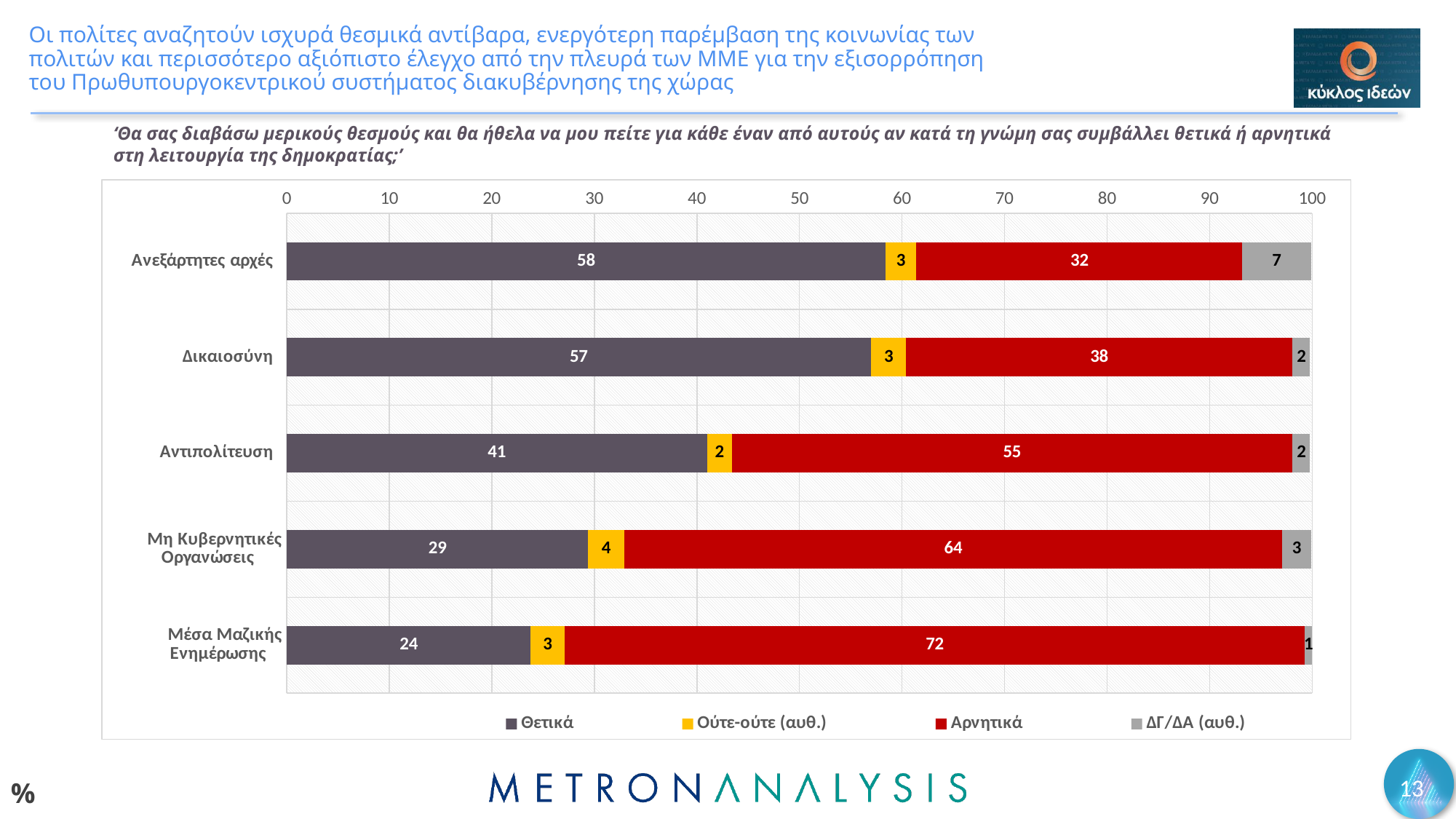
Which category has the highest Θετικά value? Ανεξάρτητες αρχές How many series does the legend list? 4 What is the ΔΓ/ΔΑ (αυθ.) value for Ανεξάρτητες αρχές? 7 What is the Αρνητικά value for Μέσα Μαζικής Ενημέρωσης? 72 What is the Θετικά value for Δικαιοσύνη? 57 What is the difference between the Αρνητικά values for Μη Κυβερνητικές Οργανώσεις and Αντιπολίτευση? 9 Which colour represents the Αρνητικά series in the legend? Red Which category has the lowest Αρνητικά value? Ανεξάρτητες αρχές How many categories are shown on the chart? 5 What kind of chart is shown on the slide? Stacked bar chart What is the total of the stacked bar for Μη Κυβερνητικές Οργανώσεις? 100 Which is larger: the Θετικά value for Αντιπολίτευση or the Αρνητικά value for Αντιπολίτευση? Αρνητικά (55)